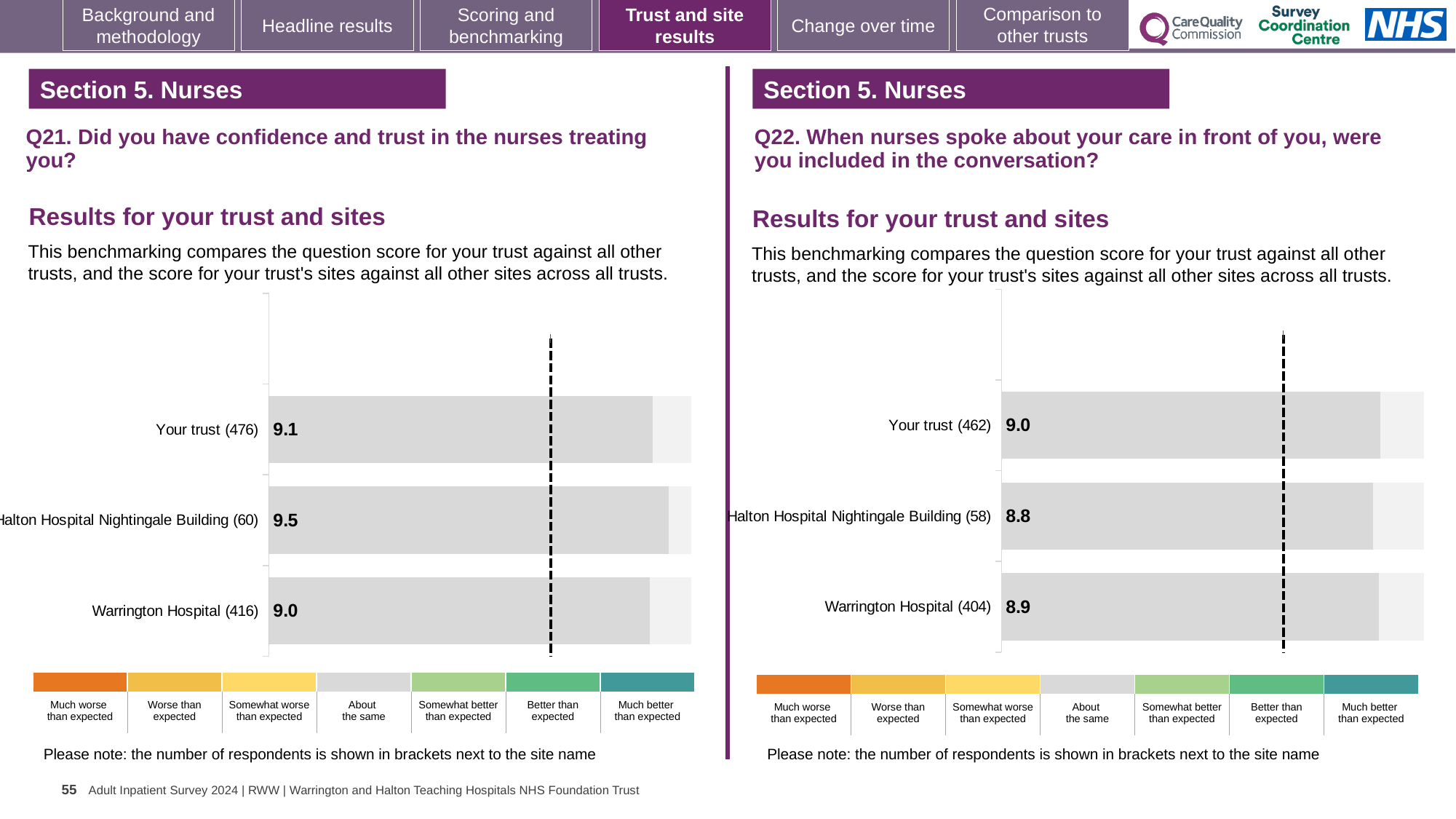
In the Q22 chart on the right, what is the score for Warrington Hospital? 8.9 What kind of chart is used for the Q22 results on the right? Bar chart In the Q21 chart on the left, what is the score for Your trust? 9.1 In the Q21 chart on the left, what is the score for Halton Hospital Nightingale Building? 9.5 In the Q22 chart on the right, what is the score for Halton Hospital Nightingale Building? 8.8 In the Q21 chart on the left, which site or trust has the highest score? Halton Hospital Nightingale Building How many bars are plotted in the Q21 chart on the left? 3 In the Q21 chart on the left, what is the score for Warrington Hospital? 9.0 In the Q22 chart on the right, which has the larger score, Your trust or Warrington Hospital? Your trust In the Q22 chart on the right, which site or trust has the lowest score? Halton Hospital Nightingale Building In the Q21 chart on the left, what is the difference between the scores for Halton Hospital Nightingale Building and Warrington Hospital? 0.5 In the Q22 chart on the right, what is the score for Your trust? 9.0